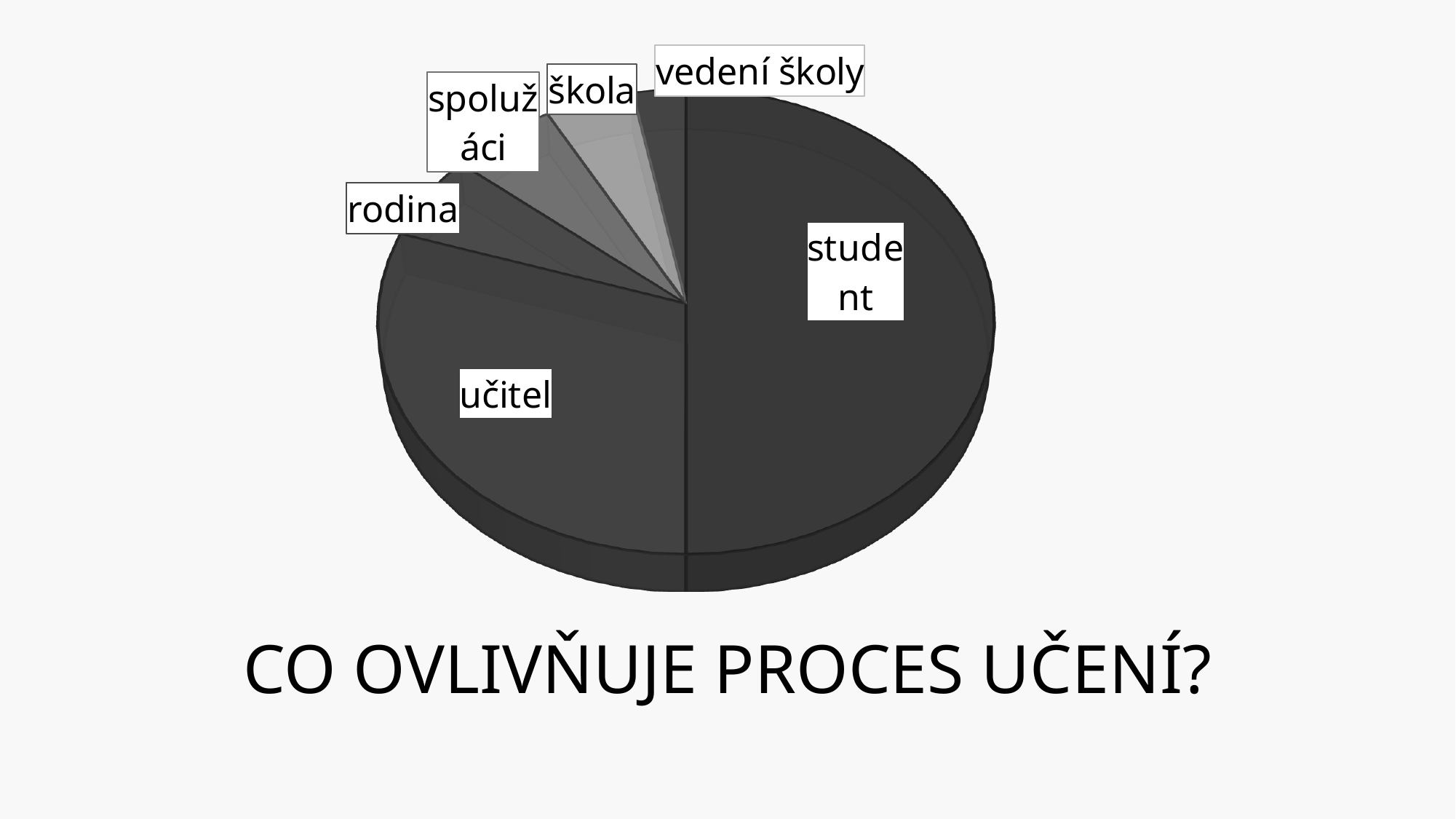
Which slice is larger, rodina or škola? rodina Which category is the second-largest slice of the pie chart? učitel Which category has the largest slice of the pie chart? student Which slice is larger, vedení školy or učitel? učitel How many slices does the pie chart have? 6 Which slice is larger, učitel or rodina? učitel Which category has the smallest slice of the pie chart? vedení školy What is the title text shown below the pie chart? CO OVLIVŇUJE PROCES UČENÍ? What kind of chart is shown on the slide? pie chart